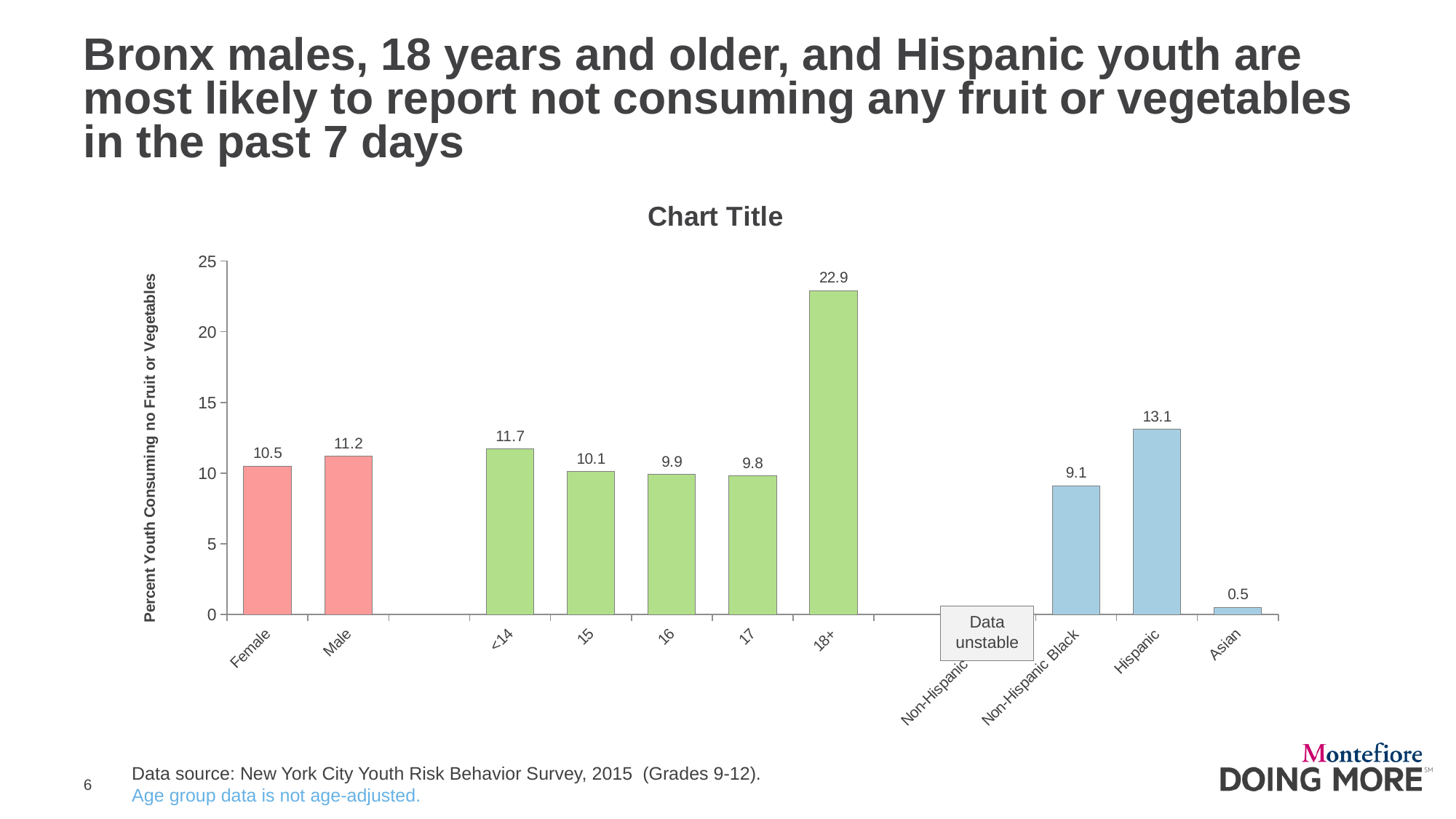
Is the value for 18+ greater or less than 20? greater What is the value for Asian? 0.5 What is the difference between the values for Male and Female? 0.7 What kind of chart is shown? bar chart What is the value for Male? 11.2 Which category has the highest value? 18+ Which is larger, the value for <14 or the value for 17? <14 What is the value for Hispanic? 13.1 What is the difference between the values for Hispanic and Non-Hispanic Black? 4.0 Which category has the lowest plotted value? Asian What is the value for the 18+ age group? 22.9 What is the y-axis label of the chart? Percent Youth Consuming no Fruit or Vegetables